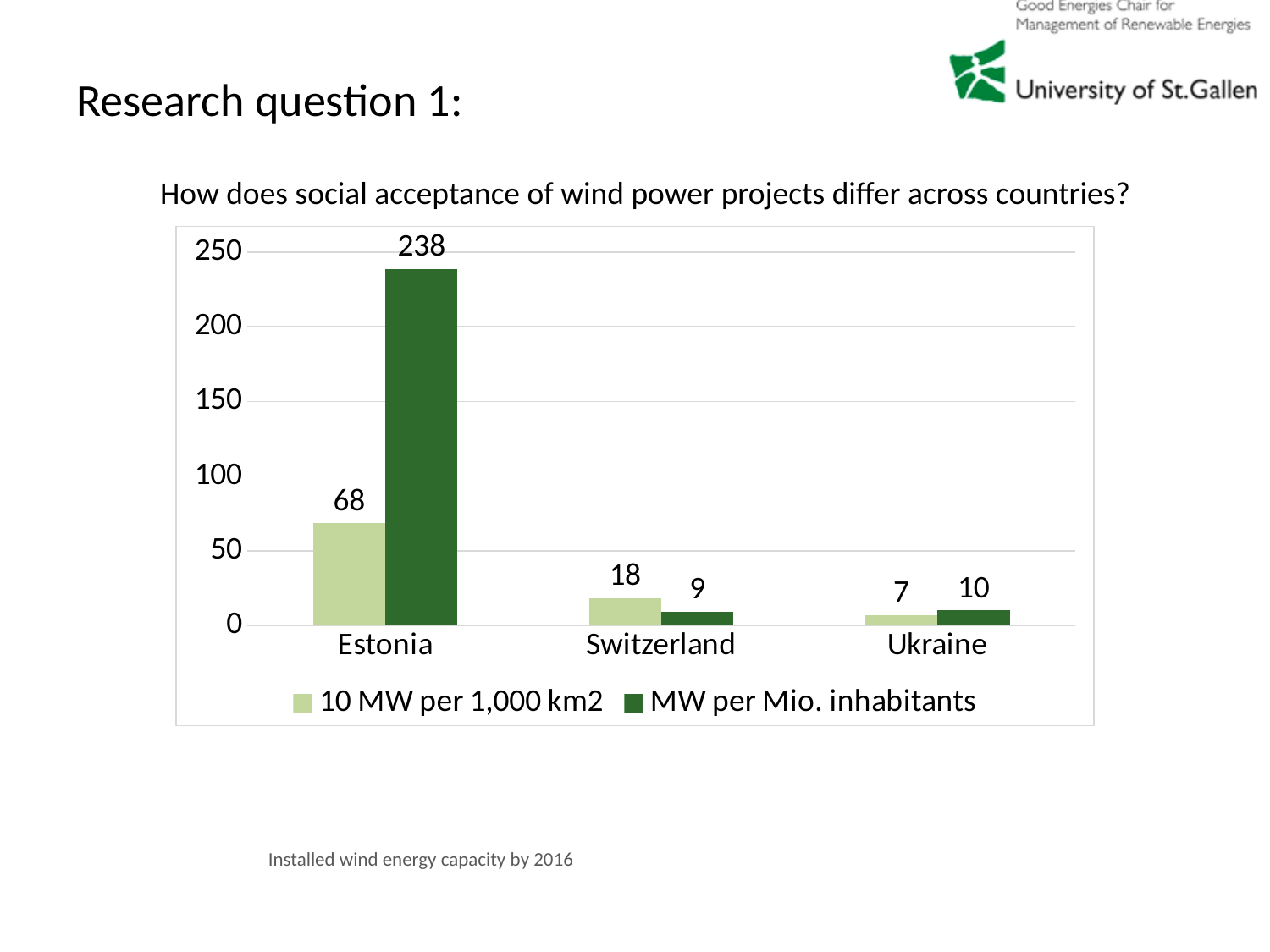
Which is larger for Switzerland: 10 MW per 1,000 km2 or MW per Mio. inhabitants? 10 MW per 1,000 km2 Which country has the lowest value for 10 MW per 1,000 km2? Ukraine What is the difference between the MW per Mio. inhabitants value and the 10 MW per 1,000 km2 value for Estonia? 170 What is the value of 10 MW per 1,000 km2 for Switzerland? 18 How many countries are shown on the x axis? 3 What is the value of MW per Mio. inhabitants for Estonia? 238 Which series is shown in dark green in the legend? MW per Mio. inhabitants How many series does the legend list? 2 Which country has the highest value for MW per Mio. inhabitants? Estonia What kind of chart is shown on the slide? bar chart Is the value of MW per Mio. inhabitants for Estonia greater or less than 200? greater What is the value of MW per Mio. inhabitants for Ukraine? 10